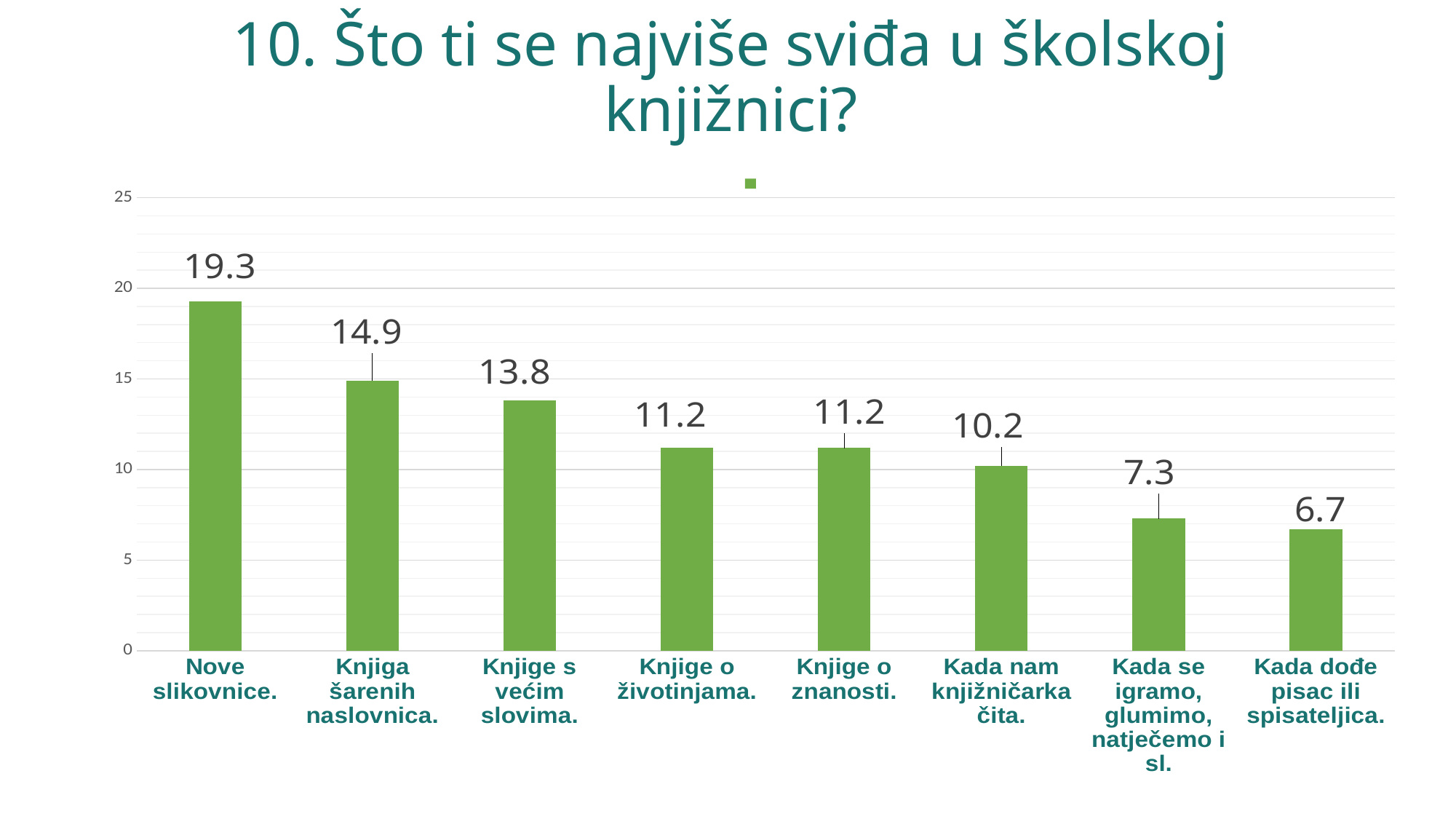
What is the title of the chart? 10. Što ti se najviše sviđa u školskoj knjižnici? Is the value for "Knjiga šarenih naslovnica." greater or less than 10? greater What is the value for "Nove slikovnice."? 19.3 What is the difference between the values for "Nove slikovnice." and "Knjiga šarenih naslovnica."? 4.4 Which category has the highest value? Nove slikovnice. What is the value for "Kada nam knjižničarka čita."? 10.2 Which category has the lowest value? Kada dođe pisac ili spisateljica. What is the value for "Kada dođe pisac ili spisateljica."? 6.7 Do the values rise or fall from left to right along the x axis? fall What kind of chart is shown on the slide? bar chart Which is larger, the value for "Knjige s većim slovima." or the value for "Kada se igramo, glumimo, natječemo i sl."? Knjige s većim slovima. How many categories are shown on the x axis? 8